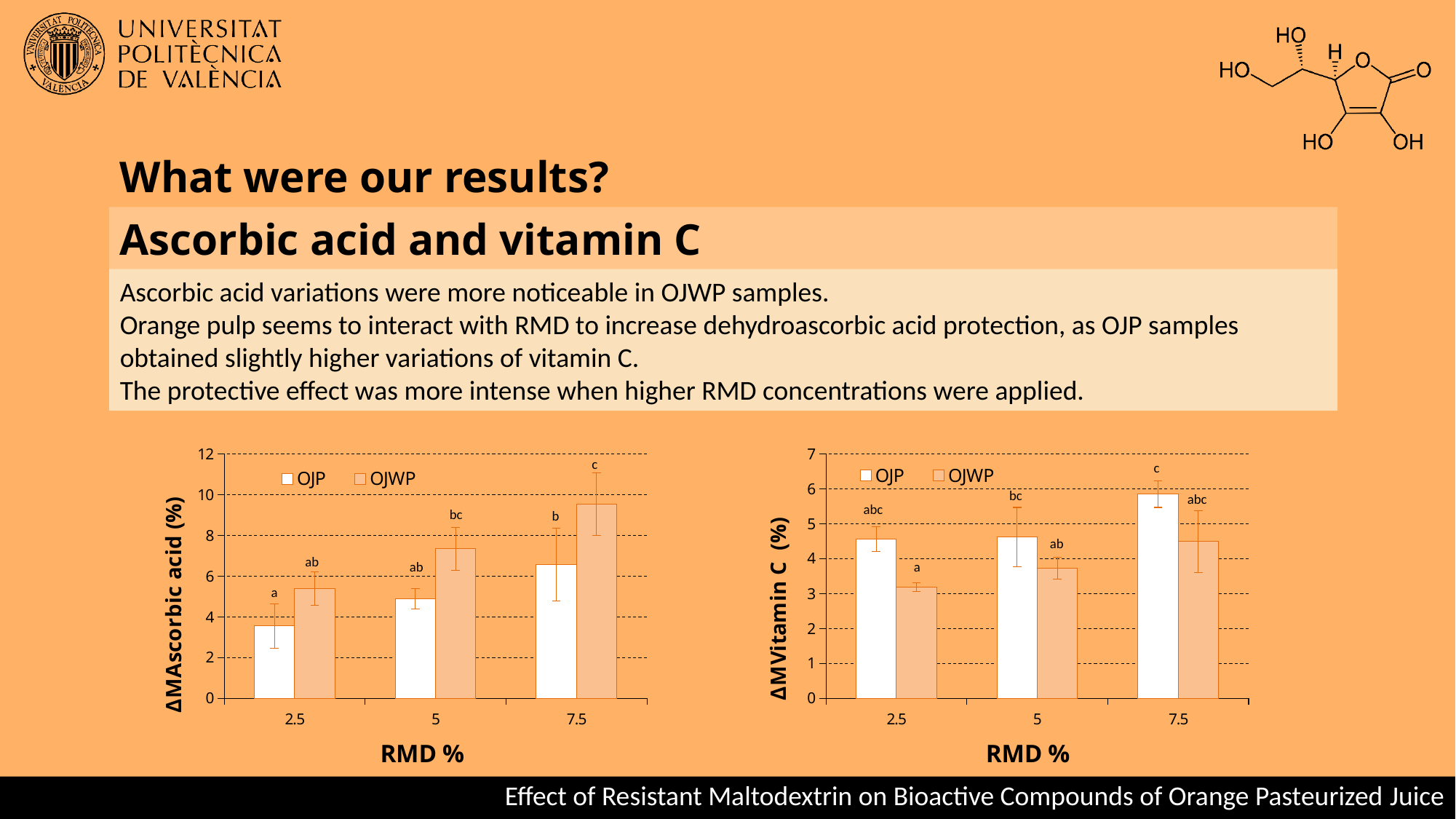
In the left chart (ΔMAscorbic acid), how many RMD % categories are shown on the x axis? 3 In the right chart (ΔMVitamin C), what is the title of the x axis? RMD % In the right chart (ΔMVitamin C), is the value for OJP at 7.5 RMD % greater or less than 5? greater In the right chart (ΔMVitamin C), is the value for OJWP at 2.5 RMD % greater or less than 4? less In the left chart (ΔMAscorbic acid), is the value for OJWP at 7.5 RMD % greater or less than 8? greater In the left chart (ΔMAscorbic acid), at which RMD % is the OJWP value highest? 7.5 In the left chart (ΔMAscorbic acid), how many series does the legend list? 2 In the left chart (ΔMAscorbic acid), at 5 RMD %, which series has the larger value, OJP or OJWP? OJWP In the left chart (ΔMAscorbic acid), what kind of chart is shown? bar chart In the left chart (ΔMAscorbic acid), do the OJWP values rise or fall as RMD % increases from 2.5 to 7.5? rise In the right chart (ΔMVitamin C), at 2.5 RMD %, which series has the larger value, OJP or OJWP? OJP